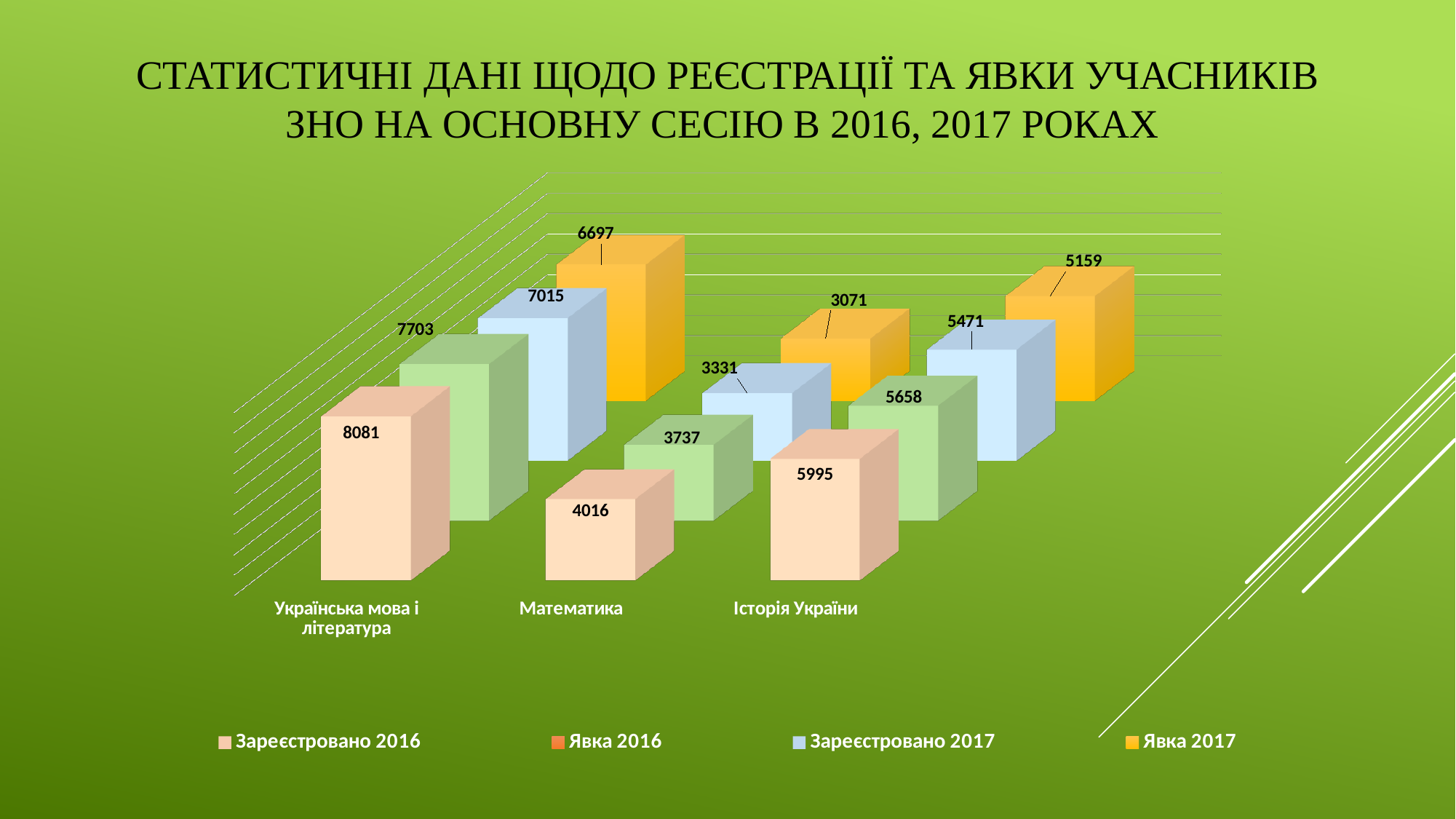
What is the value of Зареєстровано 2016 for Українська мова і література? 8081 For Історія України, which is larger: Явка 2016 or Зареєстровано 2017? Явка 2016 What is the difference between Зареєстровано 2017 and Явка 2017 for Історія України? 312 How many series does the legend list? 4 How many subjects are shown on the x axis of the chart? 3 What is the value of Явка 2017 for Математика? 3071 What is the difference between Зареєстровано 2016 and Явка 2016 for Математика? 279 What is the value of Явка 2016 for Українська мова і література? 7703 Which subject has the highest value for Зареєстровано 2016? Українська мова і література What kind of chart is shown on the slide? Bar chart What is the value of Зареєстровано 2017 for Історія України? 5471 Which subject has the lowest value for Явка 2017? Математика